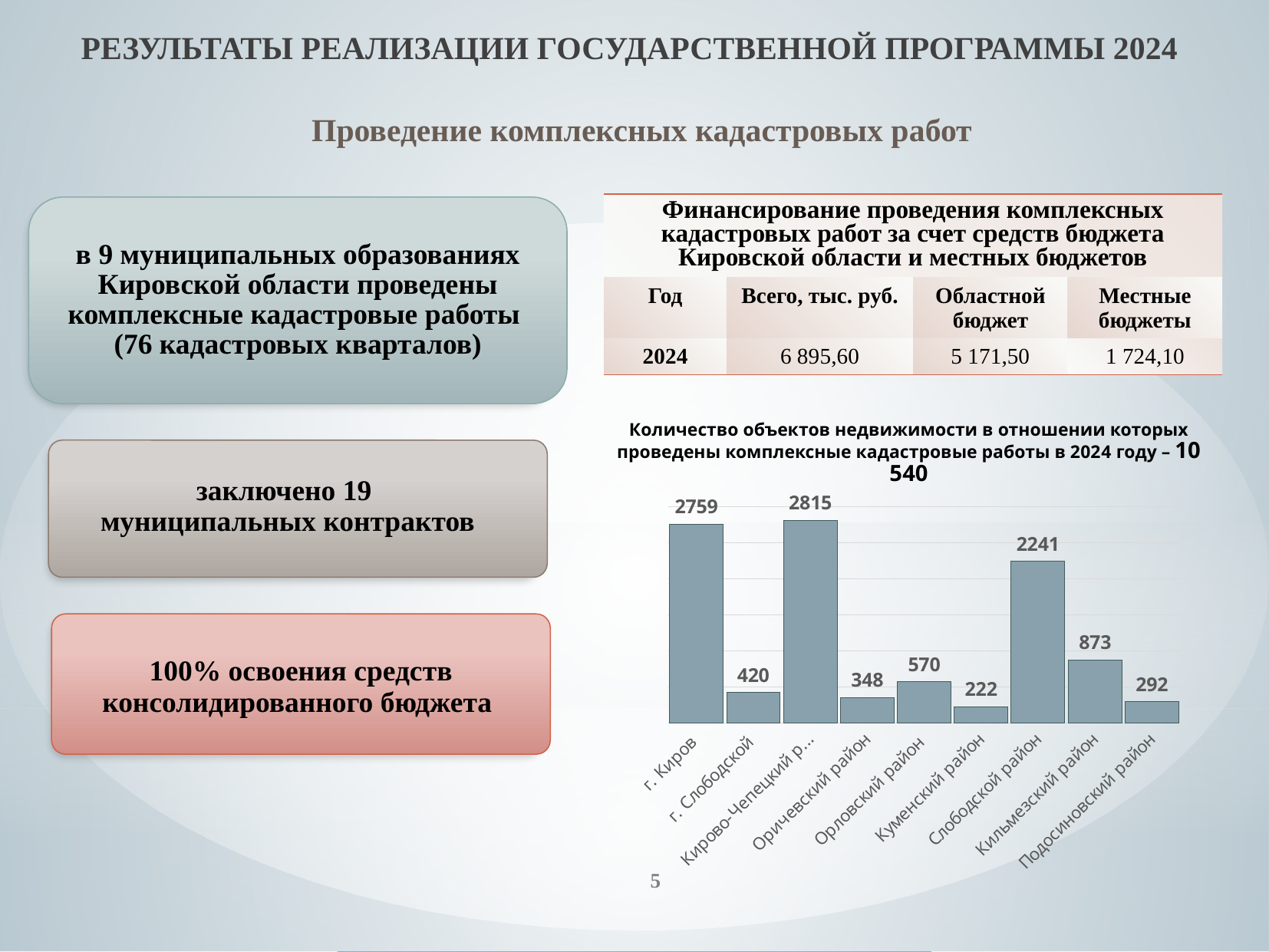
What is the difference between the values for г. Киров and Слободской район? 518 What is the value for Куменский район? 222 Which is larger, the value for г. Слободской or the value for Орловский район? Орловский район How many categories (bars) does the chart show? 9 According to the chart title, what is the total number of real estate objects for which complex cadastral works were carried out in 2024? 10 540 Which category has the lowest value? Куменский район What type of chart is shown on the slide? bar chart What is the difference between the values for Кильмезский район and Подосиновский район? 581 What is the value for Кильмезский район? 873 What is the value for г. Киров? 2759 Which is larger, the value for Оричевский район or the value for Подосиновский район? Оричевский район What is the value for Слободской район? 2241